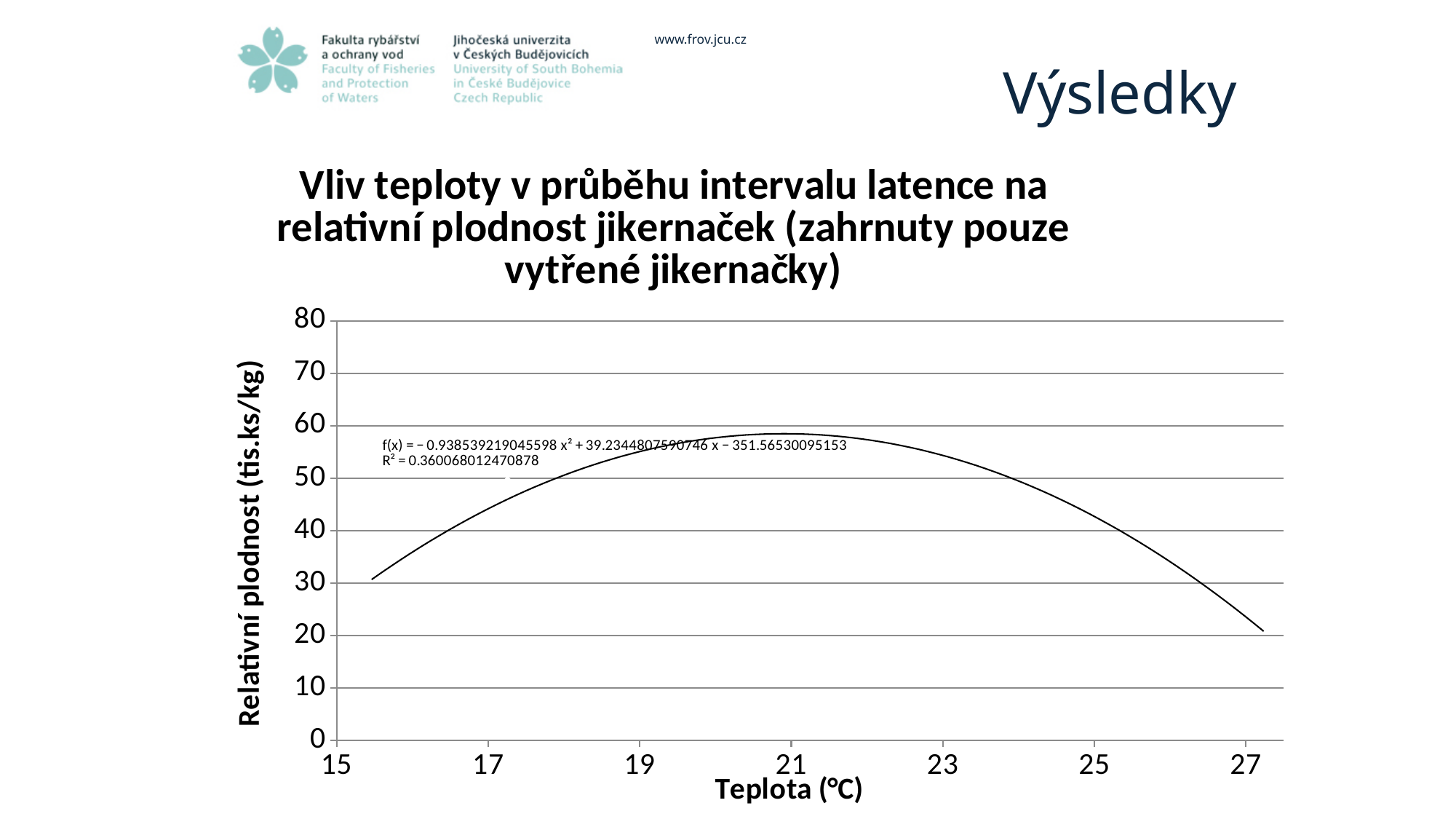
What is the R² value shown on the chart? 0.360068012470878 Is the value of the fitted curve at 25 °C greater or less than 40? greater Does the fitted curve rise or fall as temperature increases from 15 °C to 21 °C? rises Is the value of the fitted curve at 27 °C greater or less than 30? less Is the value of the fitted curve at 16 °C greater or less than 40? less What is the coefficient of the x² term in the fitted equation shown on the chart? −0.938539219045598 Does the fitted curve rise or fall as temperature increases from 21 °C to 27 °C? falls What is the label of the vertical axis? Relativní plodnost (tis.ks/kg) What is the maximum value shown on the vertical axis? 80 Is the fitted curve higher at 21 °C or at 27 °C? 21 °C What is the title of the chart? Vliv teploty v průběhu intervalu latence na relativní plodnost jikernaček (zahrnuty pouze vytřené jikernačky)